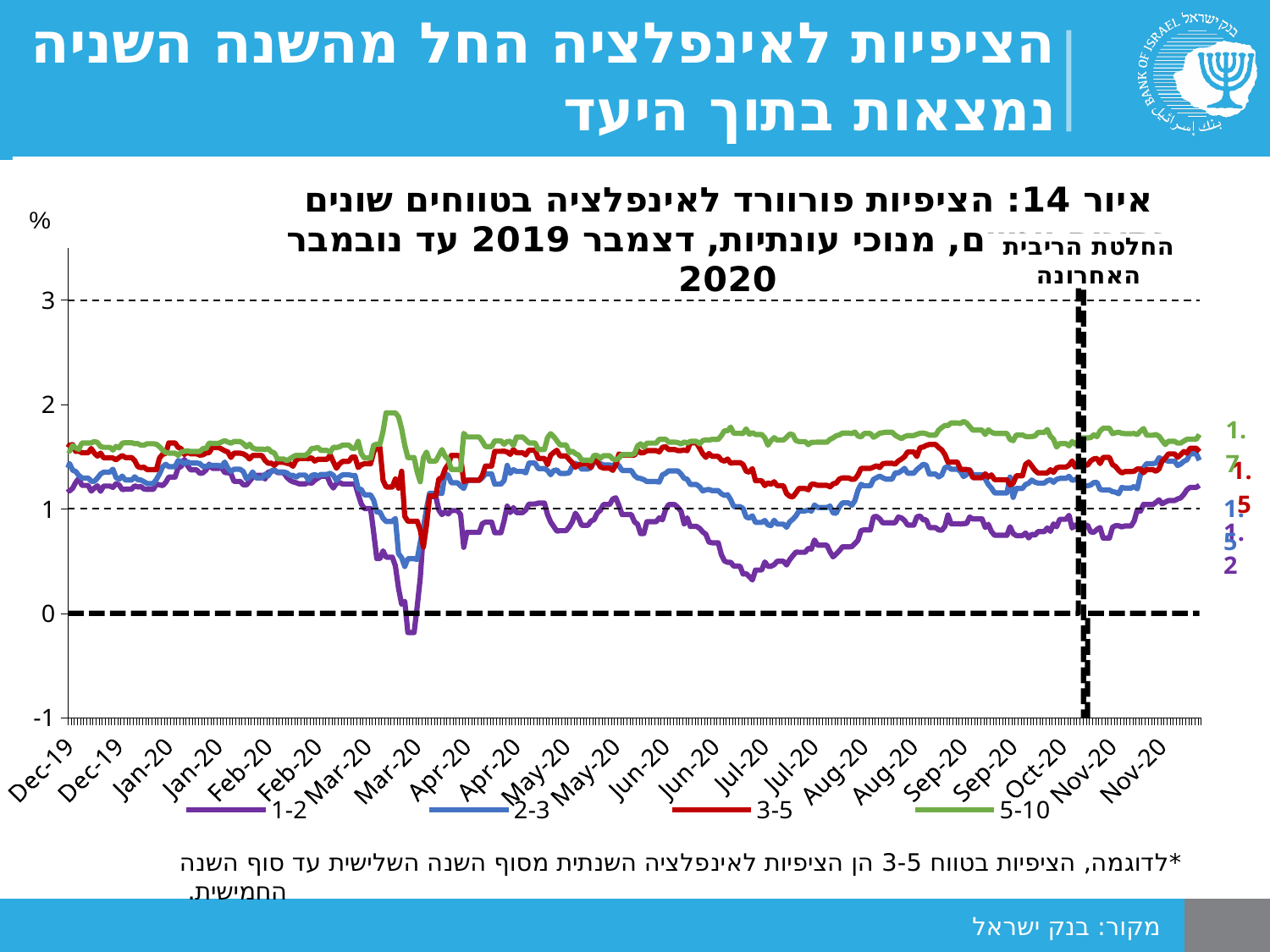
Which series has the lowest value at the end of the period (Nov-20)? 1-2 How many series does the legend list? 4 Which series is higher in Mar-20, 5-10 or 1-2? 5-10 What are the four series listed in the legend? 1-2, 2-3, 3-5, 5-10 Is the lowest value of the 1-2 series in Mar-20 greater or less than 0? less What unit is shown on the vertical axis? % Which series has the highest value at the end of the period (Nov-20)? 5-10 Is the value of the 5-10 series in Sep-20 greater or less than 1? greater Does the 1-2 series rise or fall between Jul-20 and Nov-20? rise Is the value of the 1-2 series in Jul-20 greater or less than 1? less What kind of chart is shown on the slide? line chart